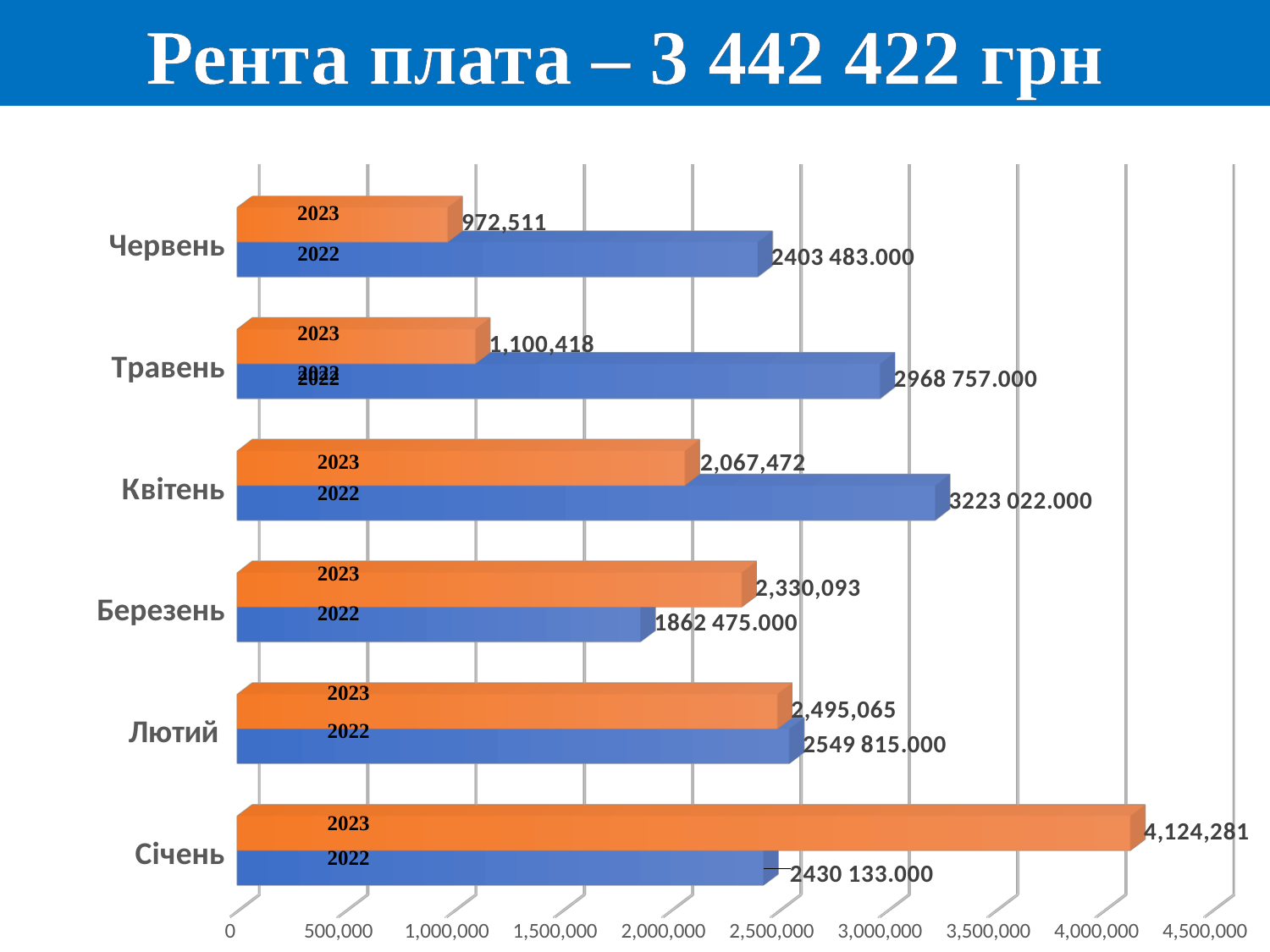
Which month has the lowest 2023 value? Червень What is the 2023 value for Січень? 4,124,281 What is the 2022 value for Квітень? 3223 022.000 Is the 2023 value for Січень greater or less than 4,000,000? greater What type of chart is shown on the slide? bar chart For Березень, which is larger: the 2023 value or the 2022 value? 2023 Which month has the lowest 2022 value? Березень Which month has the highest 2023 value? Січень What is the difference between the 2023 values for Січень and Лютий? 1,629,216 What is the 2023 value for Червень? 972,511 How many months are shown on the chart? 6 How many series does the chart show? 2